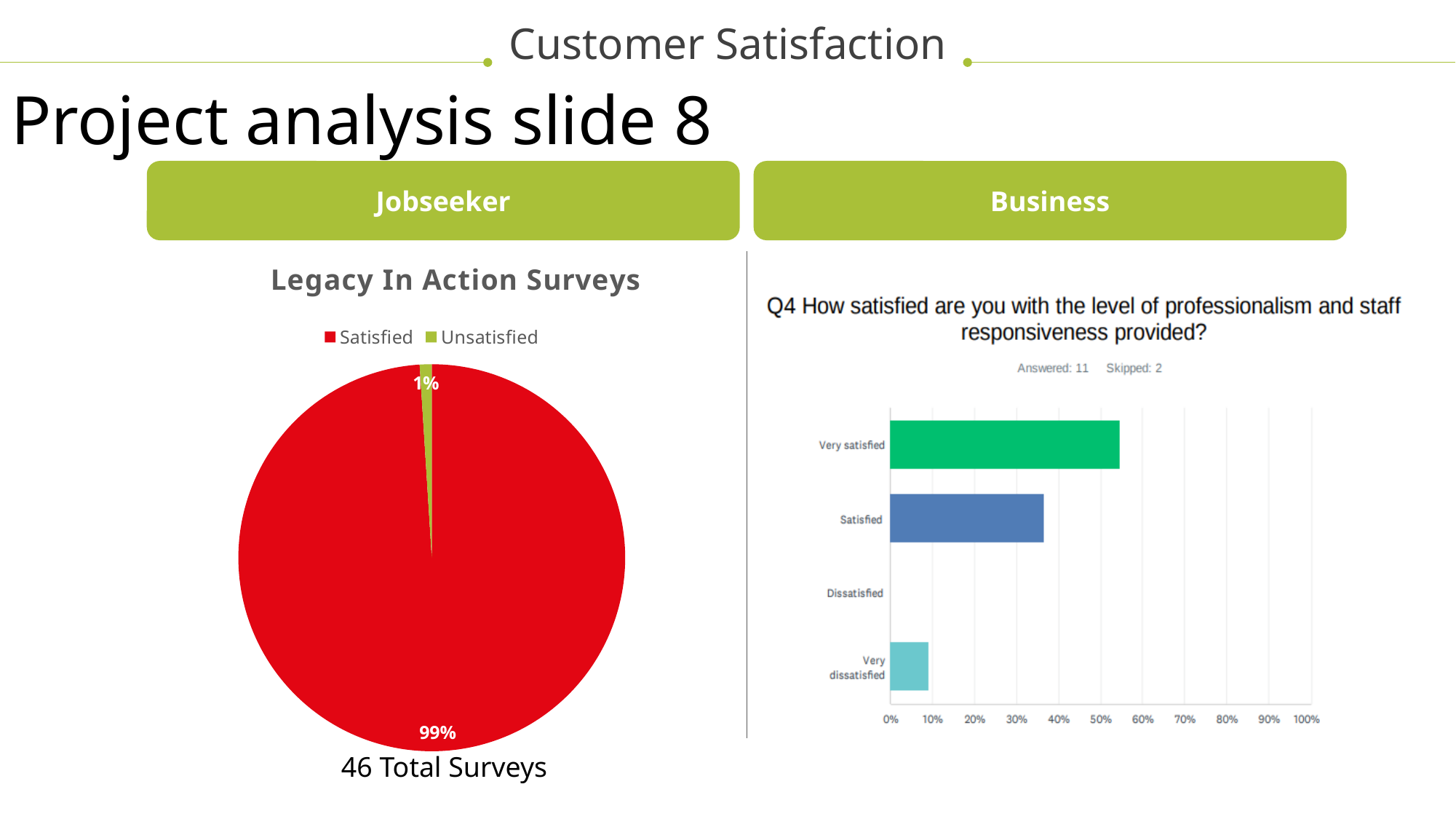
In the Q4 chart on the right, is the value for Satisfied greater or less than 40%? less In the Q4 chart on the right, is the value for Very satisfied greater or less than 50%? greater In the Legacy In Action Surveys chart, what is the difference between the Satisfied and Unsatisfied shares? 98% In the Legacy In Action Surveys chart, what share of the pie is Satisfied? 99% How many categories are shown on the Q4 chart on the right? 4 In the Q4 chart on the right, which is larger, Satisfied or Very dissatisfied? Satisfied In the Q4 chart on the right, is the value for Very dissatisfied greater or less than 20%? less In the Q4 chart on the right, which category has the longest bar? Very satisfied What kind of chart is the Legacy In Action Surveys chart? Pie chart How many entries does the legend of the Legacy In Action Surveys chart list? 2 In the Legacy In Action Surveys chart, which slice is the largest? Satisfied In the Legacy In Action Surveys chart, what share of the pie is Unsatisfied? 1%